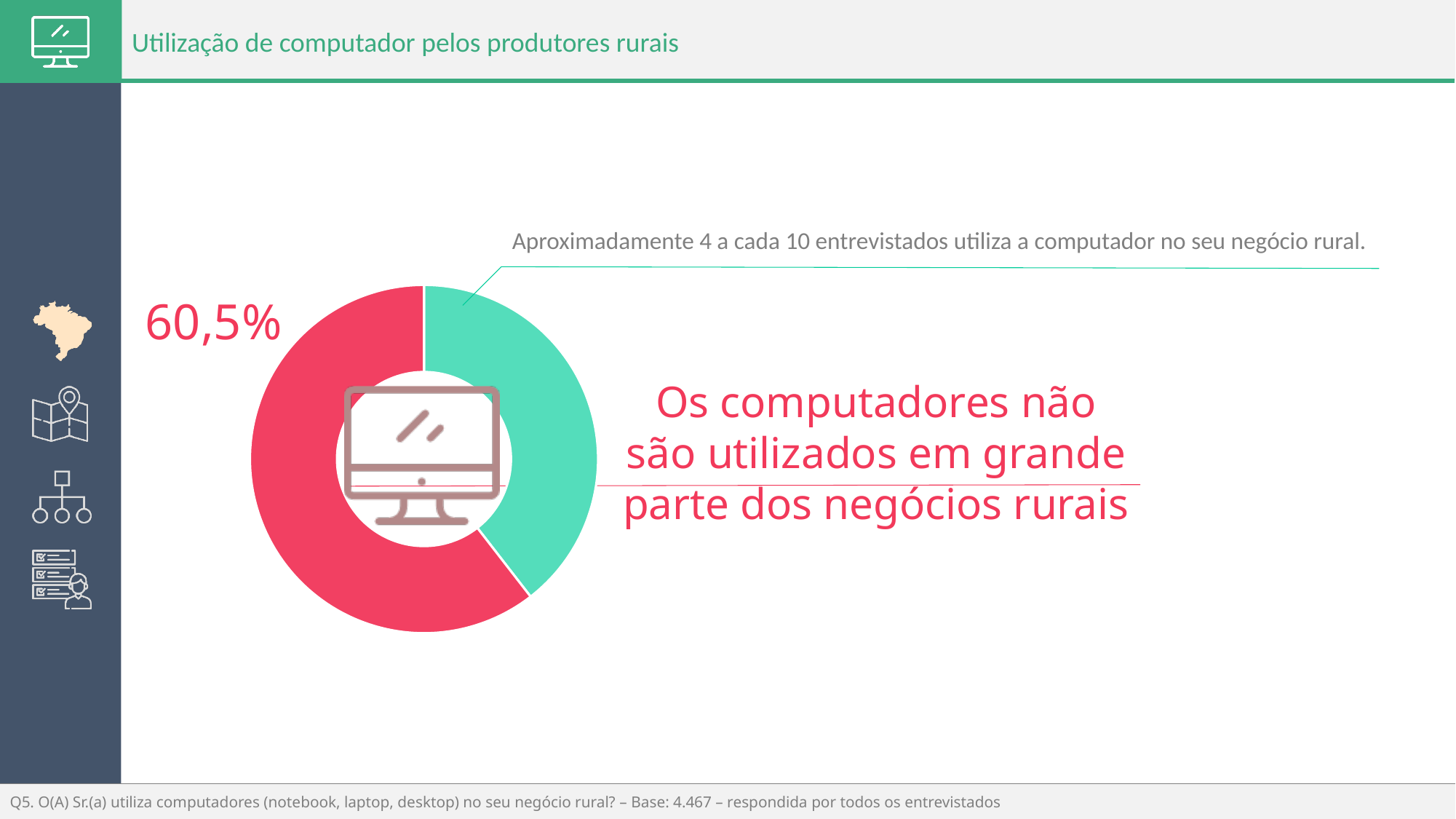
What colour is the slice labelled 60,5%? red What kind of chart is shown on the slide? pie chart (donut) What is the title of the slide containing the chart? Utilização de computador pelos produtores rurais What percentage is printed next to the red slice of the chart? 60,5% Which slice of the chart is the largest? the red slice (60,5%) Is the share of the red slice greater or less than 50%? greater Is the share of the green slice greater or less than 50%? less Which slice of the chart is larger, the red one or the green one? the red one How many slices does the chart have? 2